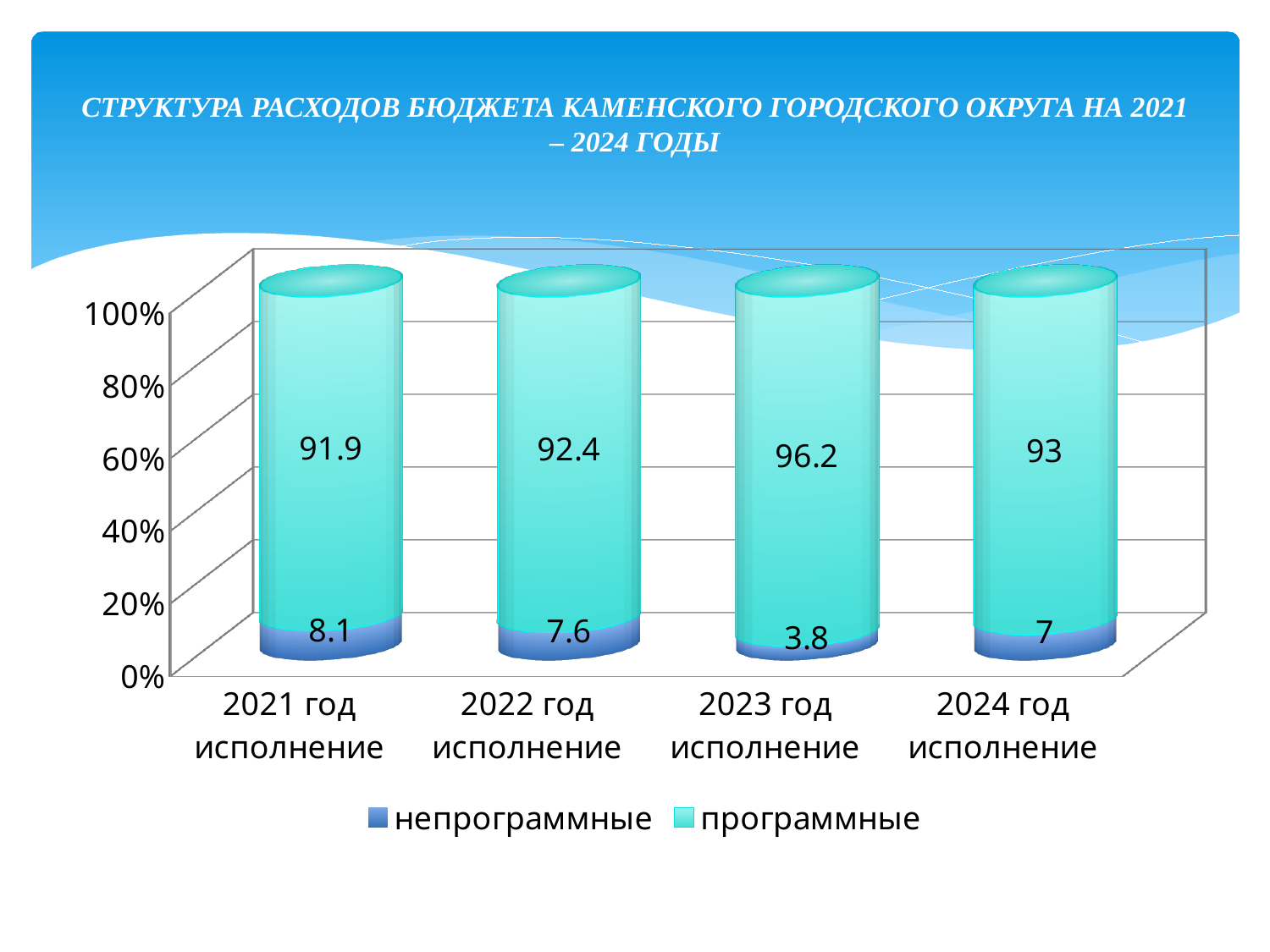
How many categories are shown on the x axis? 4 What is the value for программные in 2022 год исполнение? 92.4 What is the difference between the программные and непрограммные values in 2021 год исполнение? 83.8 What is the value for непрограммные in 2024 год исполнение? 7 What is the value for программные in 2021 год исполнение? 91.9 Which is larger: the непрограммные value for 2022 год исполнение or for 2024 год исполнение? 2022 год исполнение In which year is the value for программные the highest? 2023 год исполнение In which year is the value for непрограммные the lowest? 2023 год исполнение What is the difference between the непрограммные values for 2021 год исполнение and 2023 год исполнение? 4.3 What kind of chart is shown on the slide? Stacked bar chart What is the value for непрограммные in 2023 год исполнение? 3.8 How many series does the legend list? 2